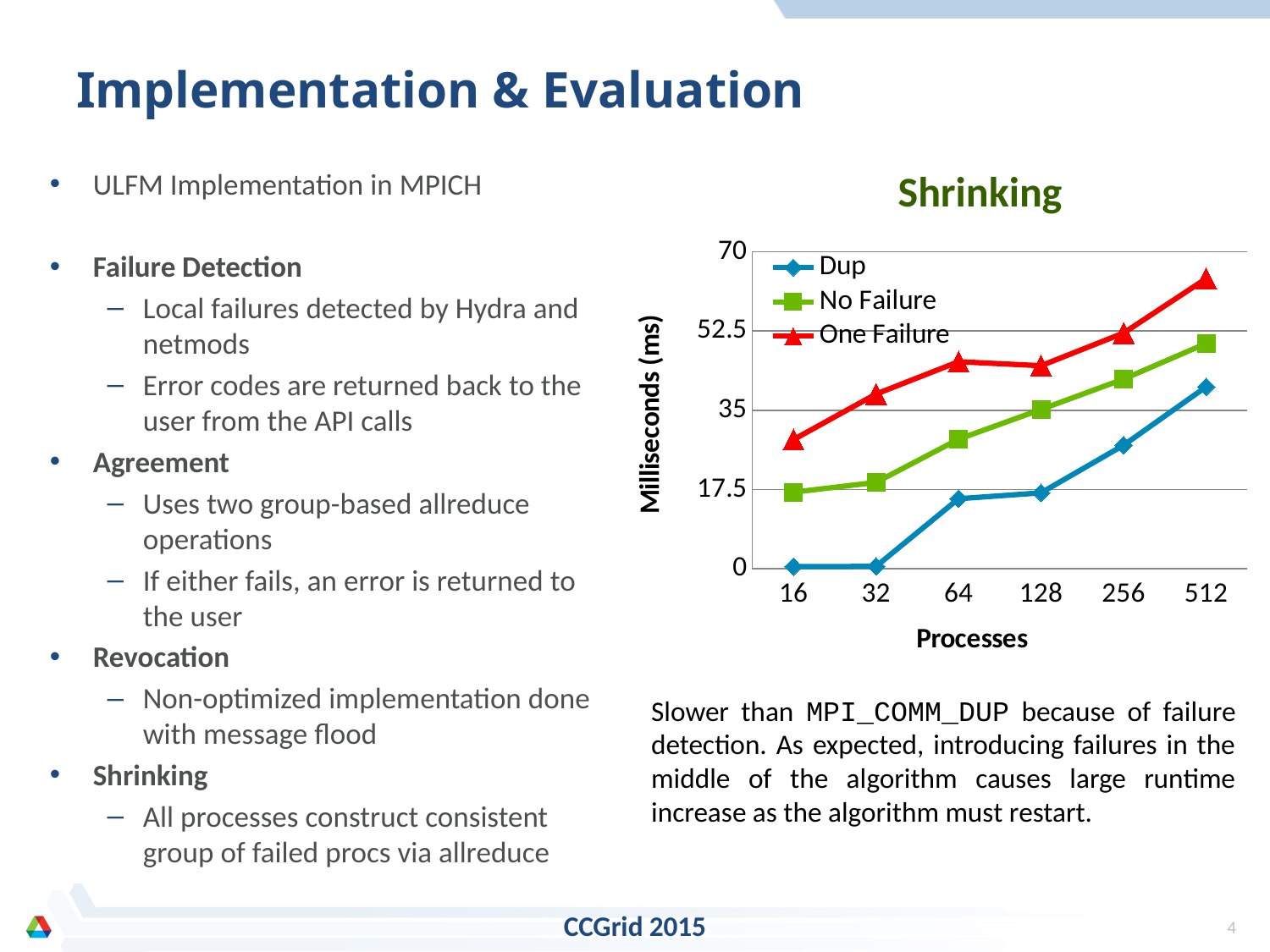
Which series has the lowest value at 16 processes? Dup How many series does the chart legend list? 3 Is the value for One Failure at 512 processes greater or less than 52.5? greater Which is larger at 128 processes, the No Failure value or the Dup value? No Failure How many process counts are plotted along the x axis? 6 Does the Dup series generally rise or fall as the number of processes increases? rise Is the value for One Failure at 16 processes greater or less than 35? less What is the label of the y axis? Milliseconds (ms) Is the value for Dup at 16 processes greater or less than 17.5? less What is the title of the chart? Shrinking What kind of chart is shown on the slide? line chart Which series has the highest value at 512 processes? One Failure